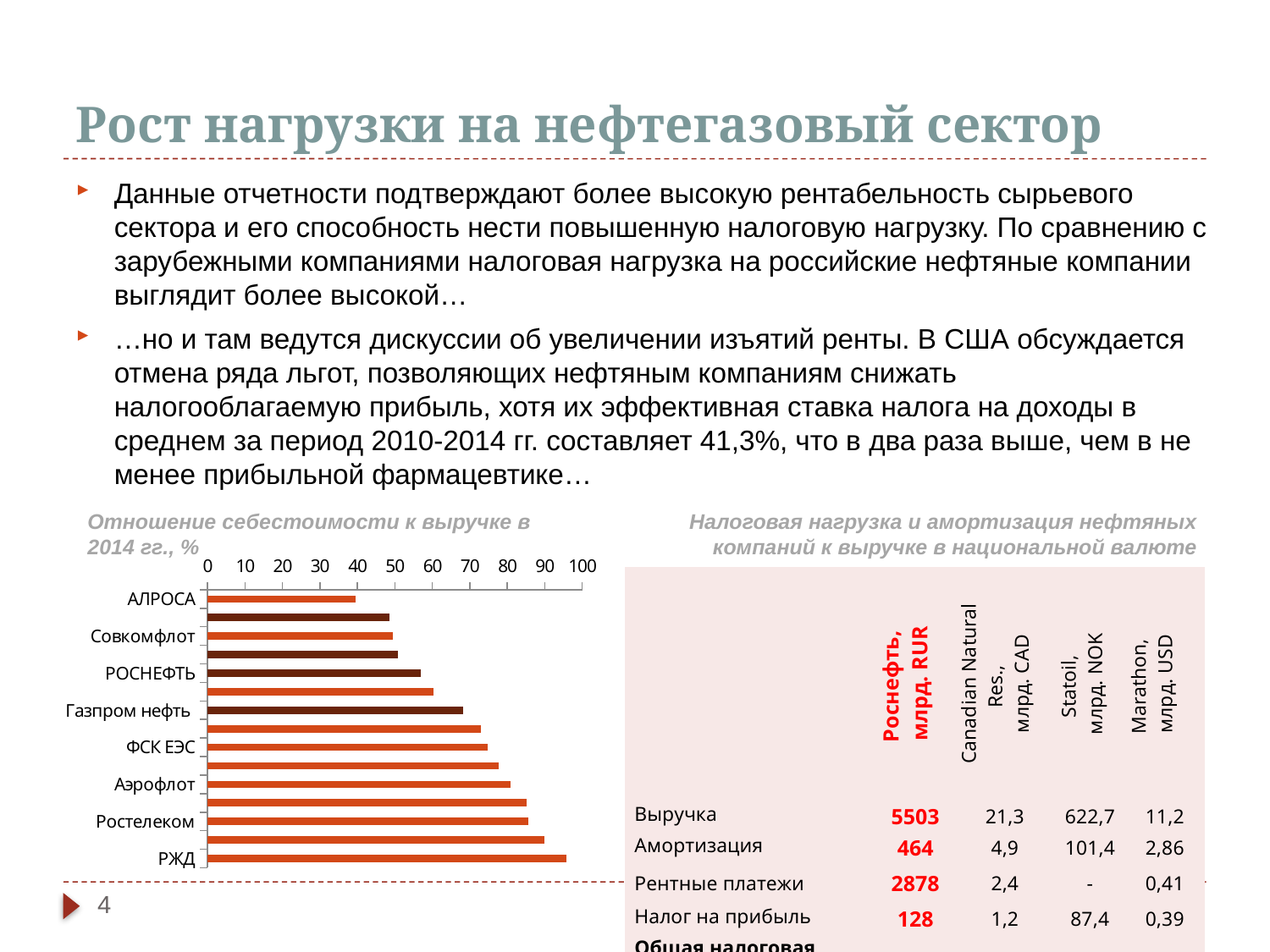
In the bar chart, do the bar values rise or fall going from АЛРОСА at the top to РЖД at the bottom? rise In the bar chart, which has the larger value, РЖД or АЛРОСА? РЖД What kind of chart is shown on the left of the slide? bar chart In the bar chart, is the value for Ростелеком greater or less than 80? greater In the bar chart, is the value for АЛРОСА greater or less than 50? less In the bar chart, which has the larger value, Ростелеком or РОСНЕФТЬ? Ростелеком In the bar chart, is the value for РЖД greater or less than 90? greater What is the title of the bar chart on the left? Отношение себестоимости к выручке в 2014 гг., % In the bar chart, which labeled company has the highest ratio of cost to revenue? РЖД In the bar chart, which labeled company has the lowest ratio of cost to revenue? АЛРОСА